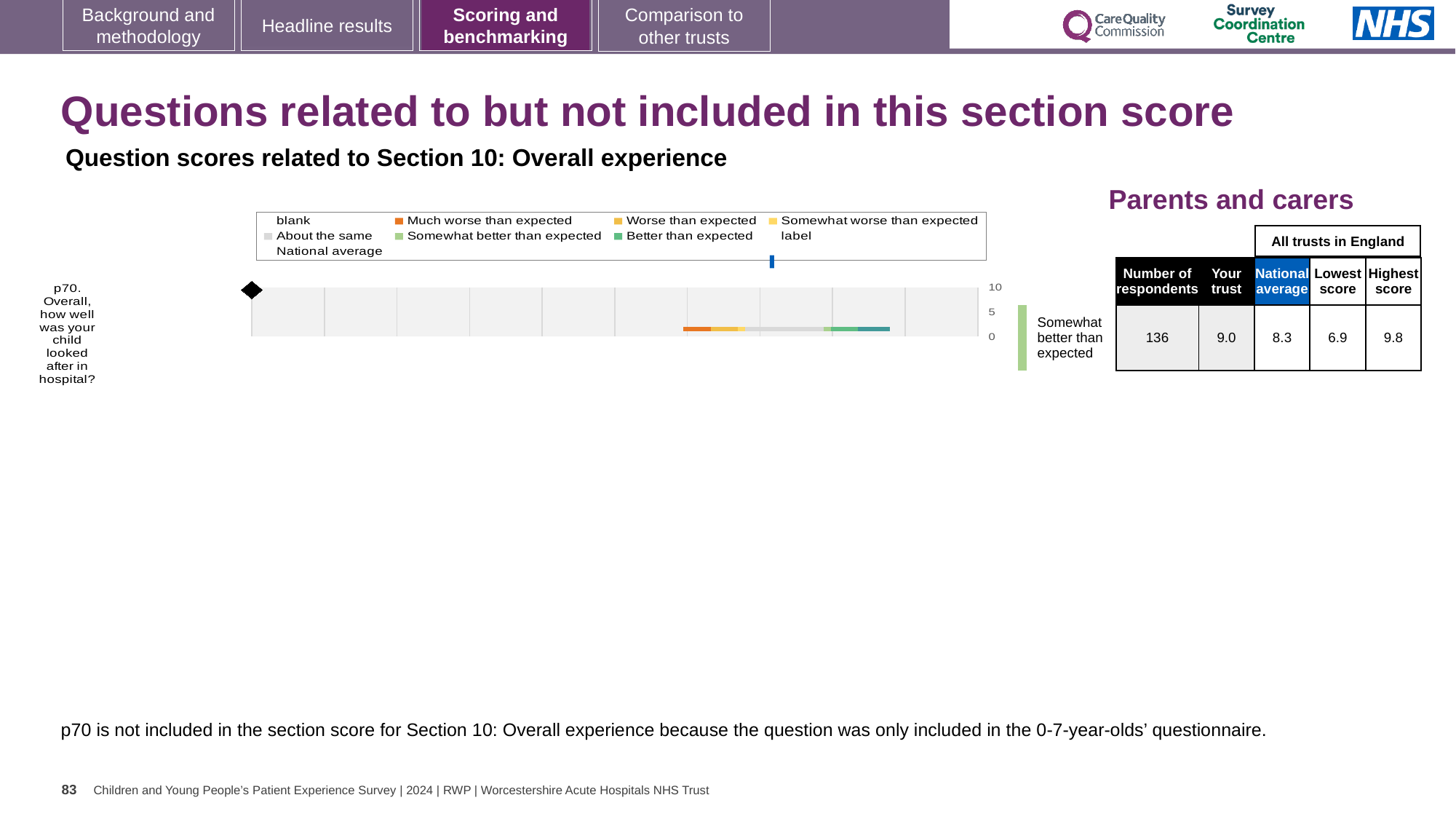
What is the difference between the trust's score and the national average for p70? 0.7 How many respondents answered p70? 136 What kind of chart is used to show the p70 question score? bar chart What is the national average score for p70 in the table beside the chart? 8.3 Which question is plotted on the chart? p70. Overall, how well was your child looked after in hospital? What is the 'Your trust' score for p70 in the table beside the chart? 9.0 What is the highest value shown on the chart's numeric axis? 10 What is the highest score among all trusts in England for p70? 9.8 What is the difference between the highest and lowest scores among all trusts in England for p70? 2.9 Is the trust's score for p70 higher or lower than the national average? higher How many survey questions are plotted on the chart? 1 What is the lowest score among all trusts in England for p70? 6.9